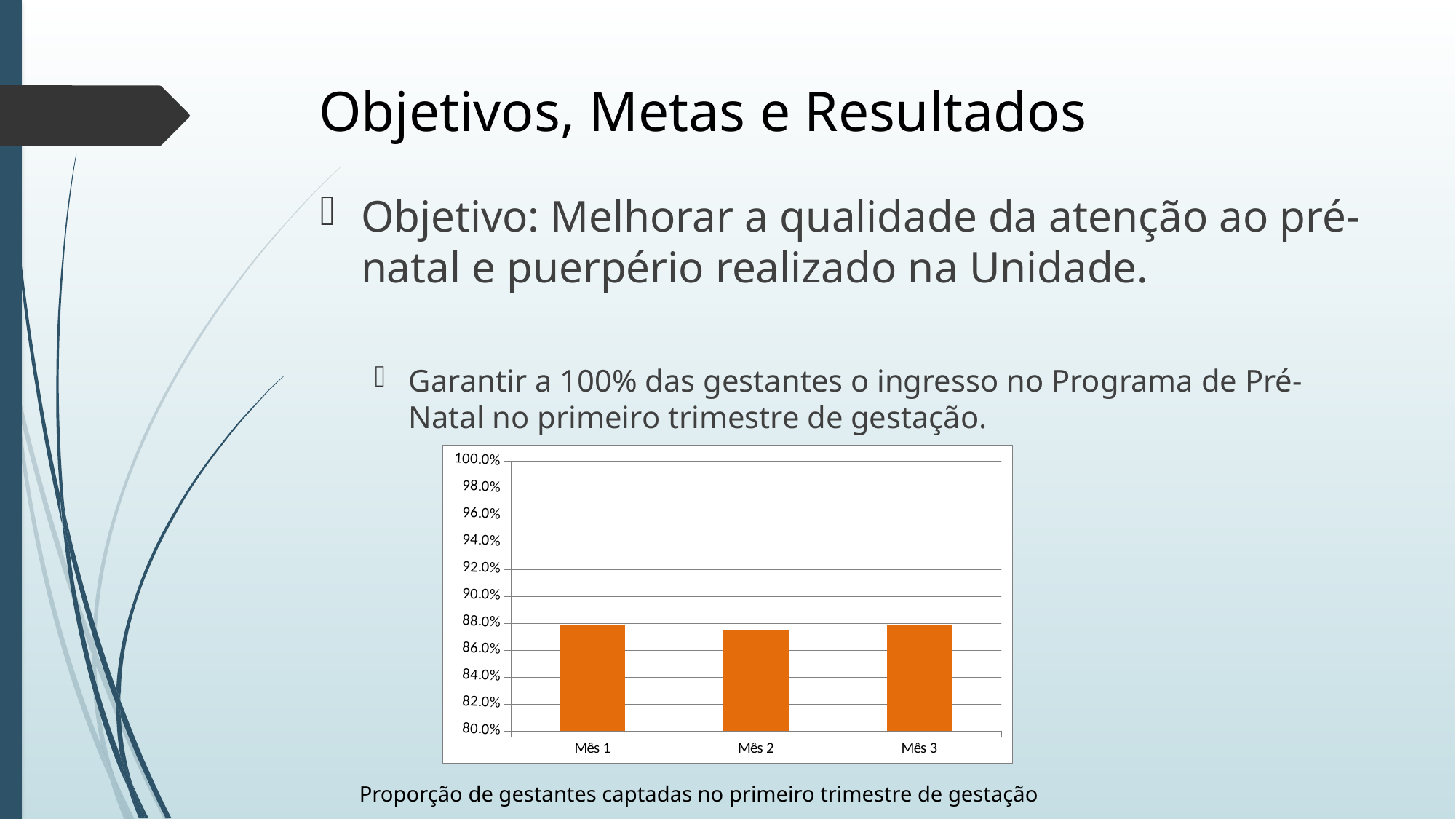
Is the value for Mês 3 greater or less than 90.0%? less Which is larger, the value for Mês 1 or the value for Mês 2? Mês 1 What is the caption below the chart? Proporção de gestantes captadas no primeiro trimestre de gestação Is the value for Mês 1 greater or less than 86.0%? greater Is the value for Mês 2 greater or less than 88.0%? less Which month has the lowest value in the chart? Mês 2 How many categories (months) are plotted in the chart? 3 What is the highest value shown on the chart's vertical axis? 100.0% What kind of chart is shown on the slide? bar chart